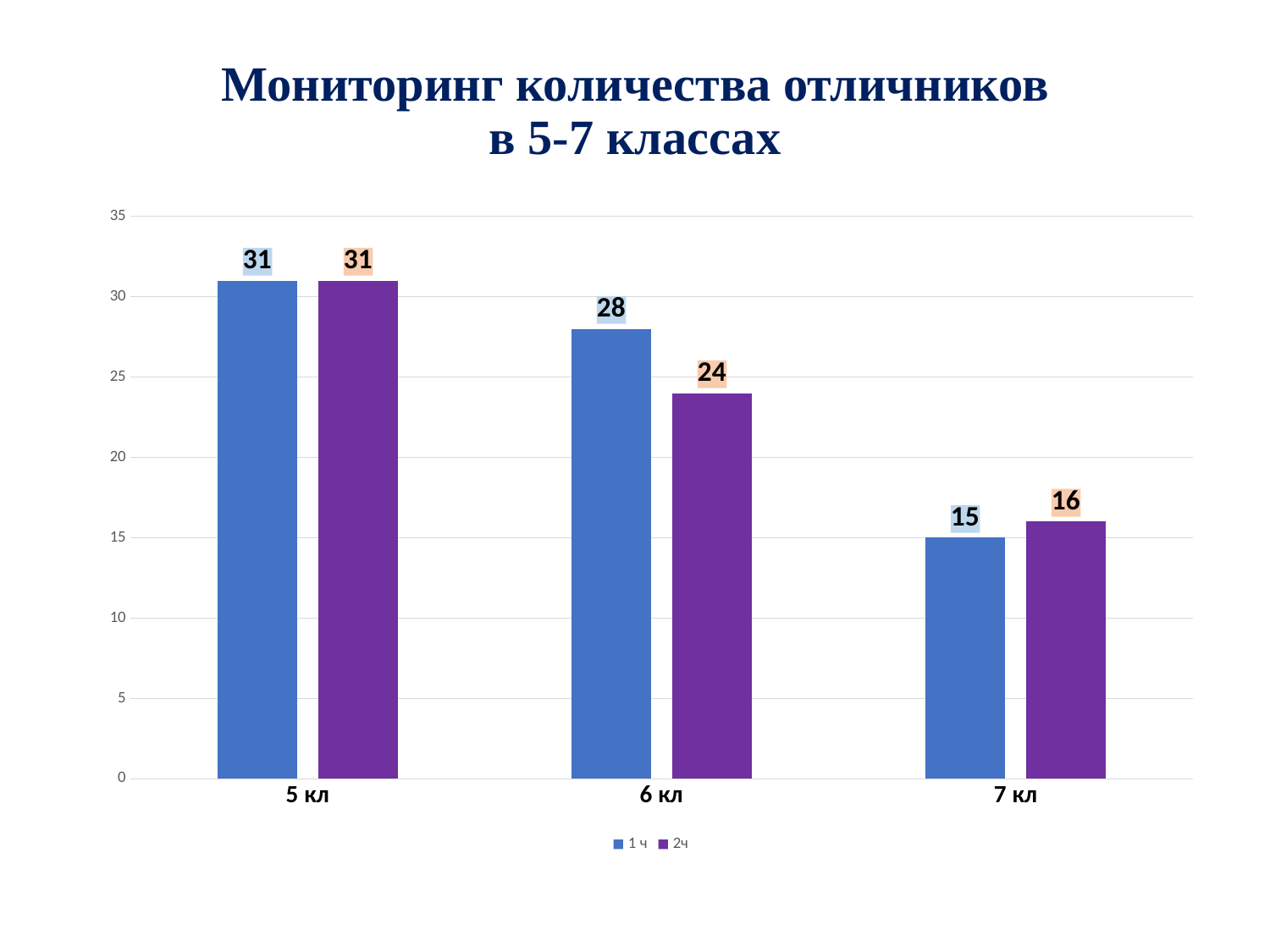
What is the value for 7 кл in the 1 ч series? 15 What is the difference between the 1 ч and 2ч values for 6 кл? 4 What is the value for 5 кл in the 1 ч series? 31 Which class has the highest value in the 1 ч series? 5 кл How many series does the legend list? 2 What is the value for 6 кл in the 2ч series? 24 For 7 кл, which series has the larger value, 1 ч or 2ч? 2ч Do the values in the 1 ч series rise or fall from 5 кл to 7 кл? Fall What kind of chart is shown on the slide? Bar chart Which class has the lowest value in the 2ч series? 7 кл What is the title of the chart? Мониторинг количества отличников в 5-7 классах How many classes are shown on the x axis? 3